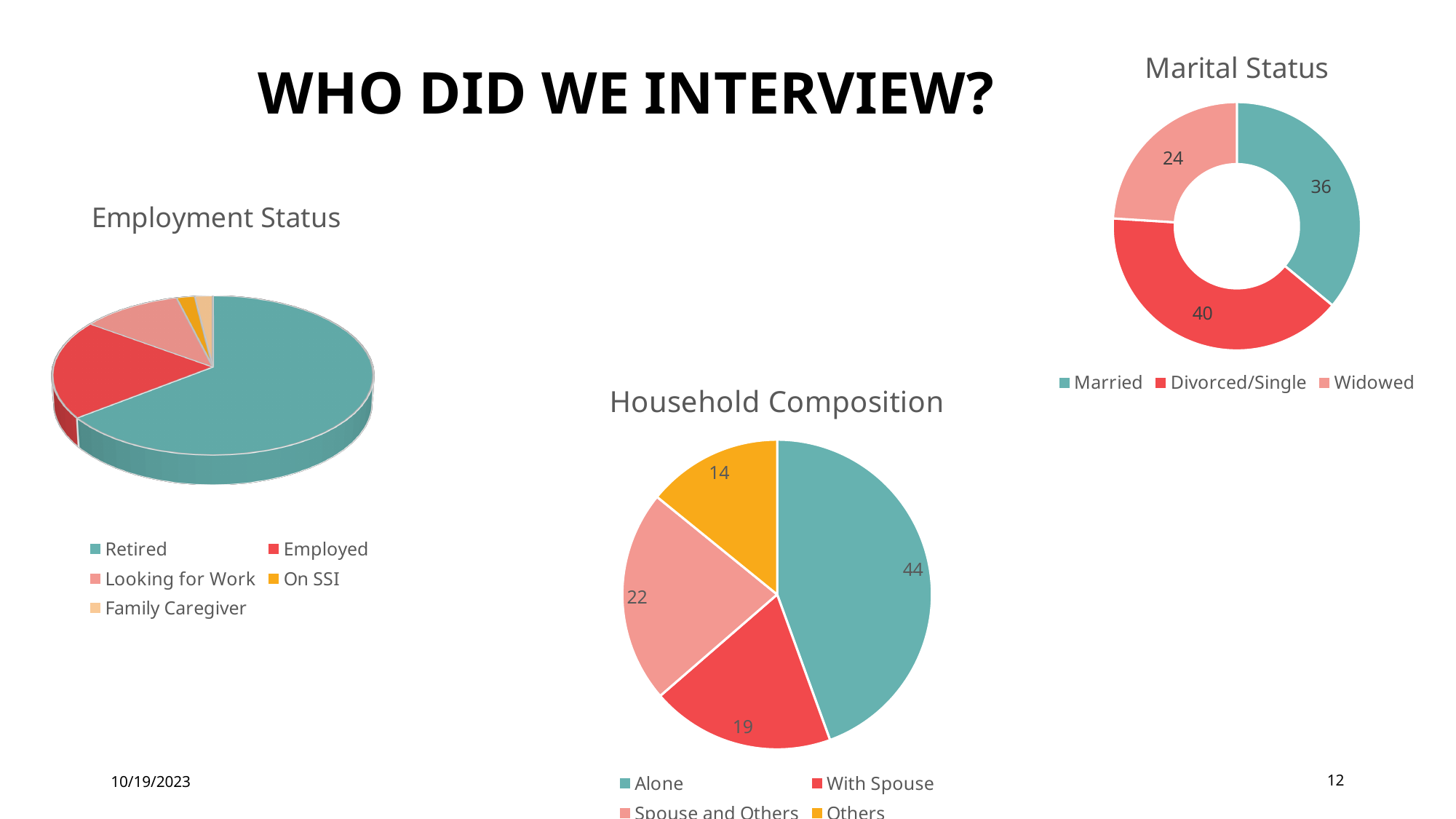
In the Household Composition chart, what is the value for Spouse and Others? 22 In the Marital Status chart, what is the value for Widowed? 24 In the Employment Status chart, which slice is larger, Employed or Looking for Work? Employed In the Marital Status chart, which category has the highest value? Divorced/Single In the Household Composition chart, which category has the lowest value? Others In the Employment Status chart, which category has the largest slice? Retired In the Marital Status chart, what share of the total does Widowed represent? 24% In the Household Composition chart, what is the value for Alone? 44 In the Household Composition chart, what is the difference between Alone and With Spouse? 25 In the Marital Status chart, what is the difference between Married and Widowed? 12 In the Marital Status chart, what is the value for Divorced/Single? 40 How many categories does the Employment Status chart's legend list? 5